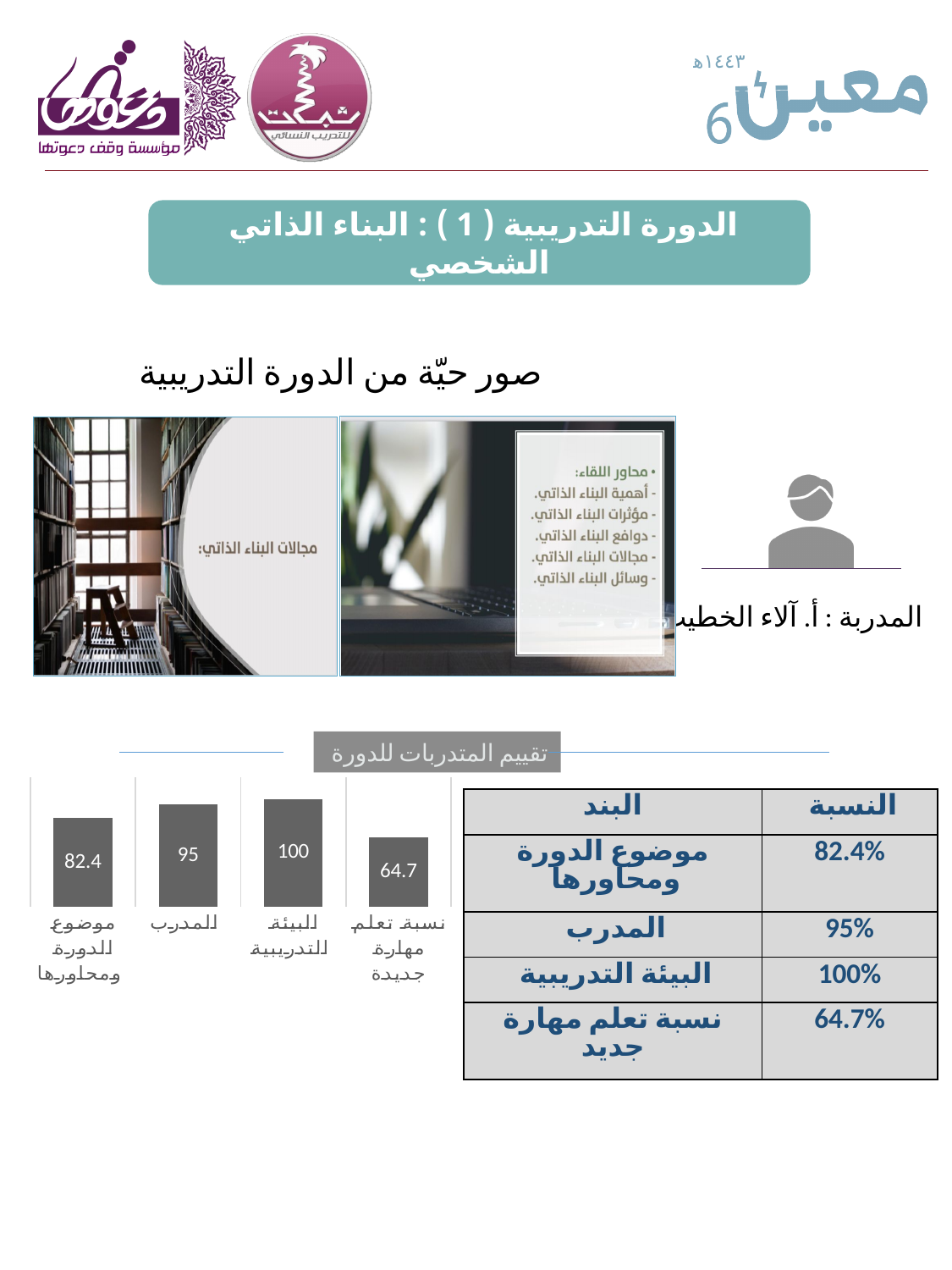
Which is larger, the value for المدرب or the value for موضوع الدورة ومحاورها? المدرب What is the value of the bar for نسبة تعلم مهارة جديدة? 64.7 What is the difference between the values for المدرب and موضوع الدورة ومحاورها? 12.6 Which category has the highest value in the chart? البيئة التدريبية What is the difference between the values for البيئة التدريبية and نسبة تعلم مهارة جديدة? 35.3 Which category has the lowest value in the chart? نسبة تعلم مهارة جديدة What is the value of the bar for موضوع الدورة ومحاورها? 82.4 What colour are the bars in the chart? dark grey How many bars (categories) does the chart show? 4 What type of chart is shown on the slide? bar chart What is the value of the bar for البيئة التدريبية? 100 What is the value of the bar for المدرب? 95